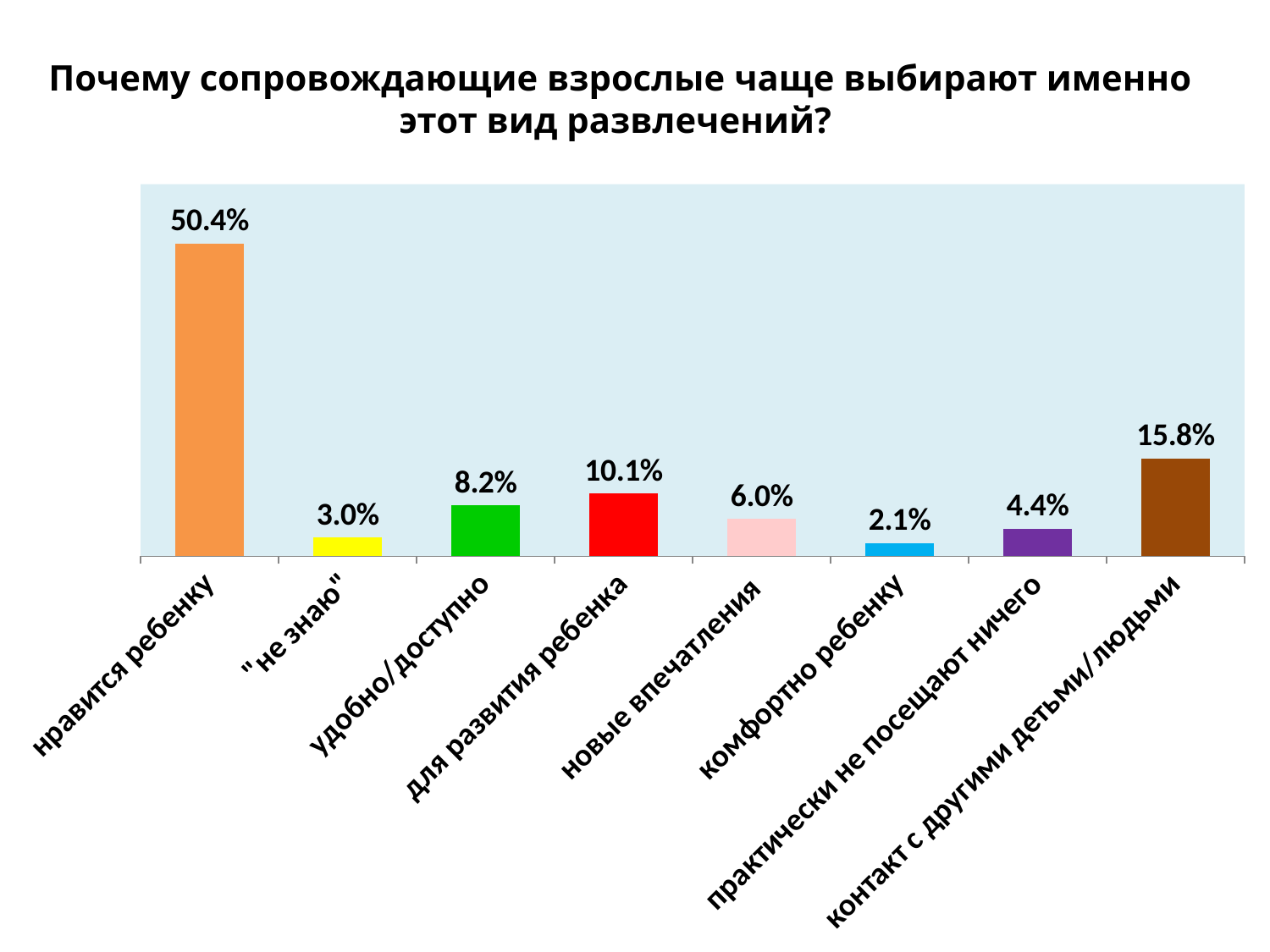
What is the value for "нравится ребенку"? 50.4% What is the value for "для развития ребенка"? 10.1% What is the value for "контакт с другими детьми/людьми"? 15.8% What is the value for "комфортно ребенку"? 2.1% What is the difference between the values for "для развития ребенка" and "удобно/доступно"? 1.9% Which category has the highest value? нравится ребенку What kind of chart is shown on the slide? bar chart Which is larger: the value for "новые впечатления" or the value for "практически не посещают ничего"? новые впечатления How many categories are shown in the chart? 8 What is the difference between the values for "нравится ребенку" and "контакт с другими детьми/людьми"? 34.6% Which category has the lowest value? комфортно ребенку What is the title of the chart? Почему сопровождающие взрослые чаще выбирают именно этот вид развлечений?